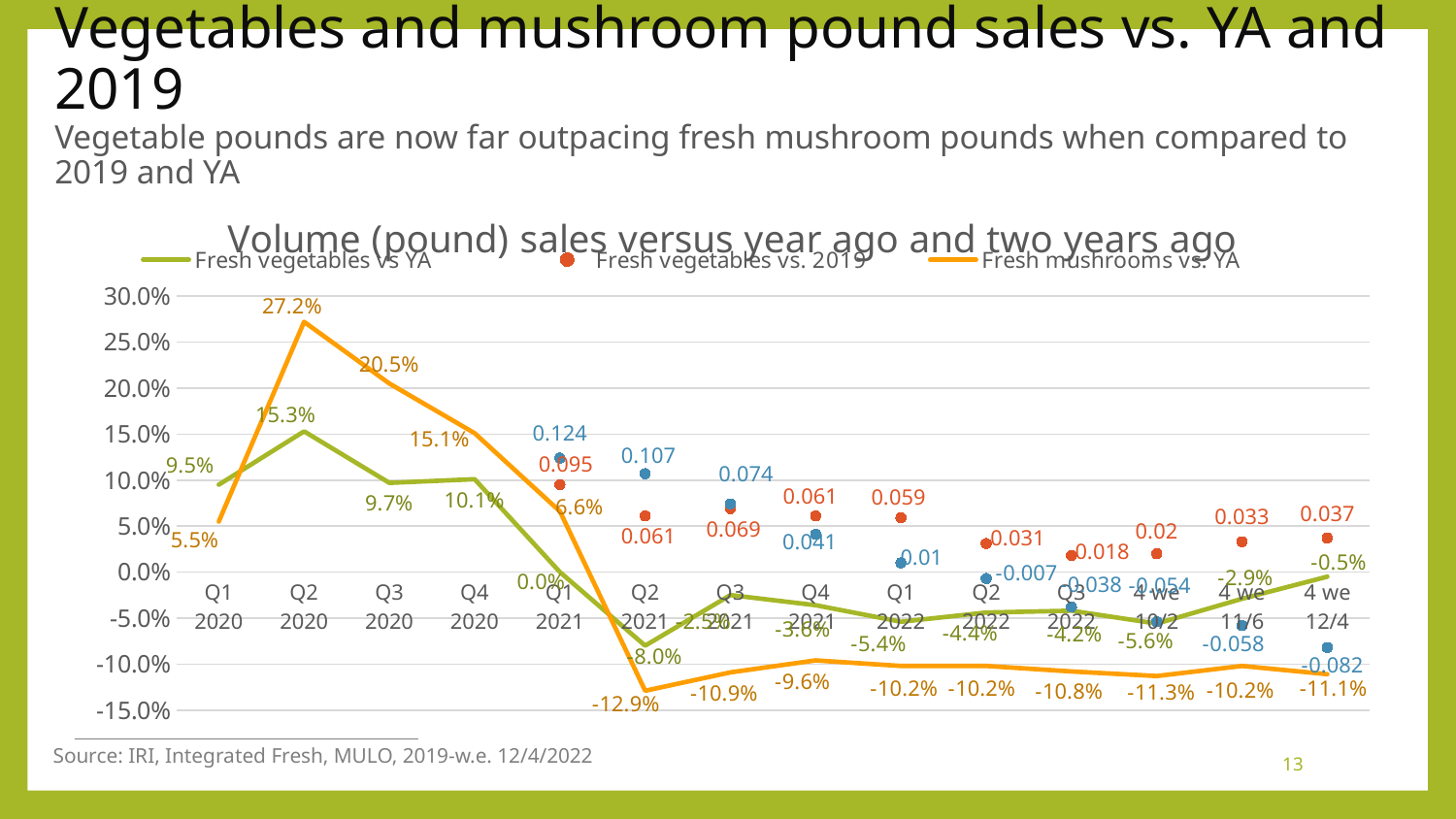
What is the value of Fresh mushrooms vs. YA in Q2 2020? 27.2% What is the value of Fresh vegetables vs. 2019 for the 4 we 12/4 period? 0.037 In Q2 2020, how many percentage points higher is Fresh mushrooms vs. YA than Fresh vegetables vs YA? 11.9 percentage points What is the value of Fresh vegetables vs YA for the 4 we 12/4 period? -0.5% In which period is Fresh mushrooms vs. YA lowest? Q2 2021 In which period is Fresh vegetables vs YA highest? Q2 2020 How many time periods are shown on the x axis? 14 In which period is Fresh mushrooms vs. YA highest? Q2 2020 Does Fresh mushrooms vs. YA rise or fall from Q2 2020 to Q2 2021? fall In Q1 2020, which is larger: Fresh vegetables vs YA or Fresh mushrooms vs. YA? Fresh vegetables vs YA How many series does the legend list? 3 What is the value of Fresh vegetables vs YA in Q2 2021? -8.0%